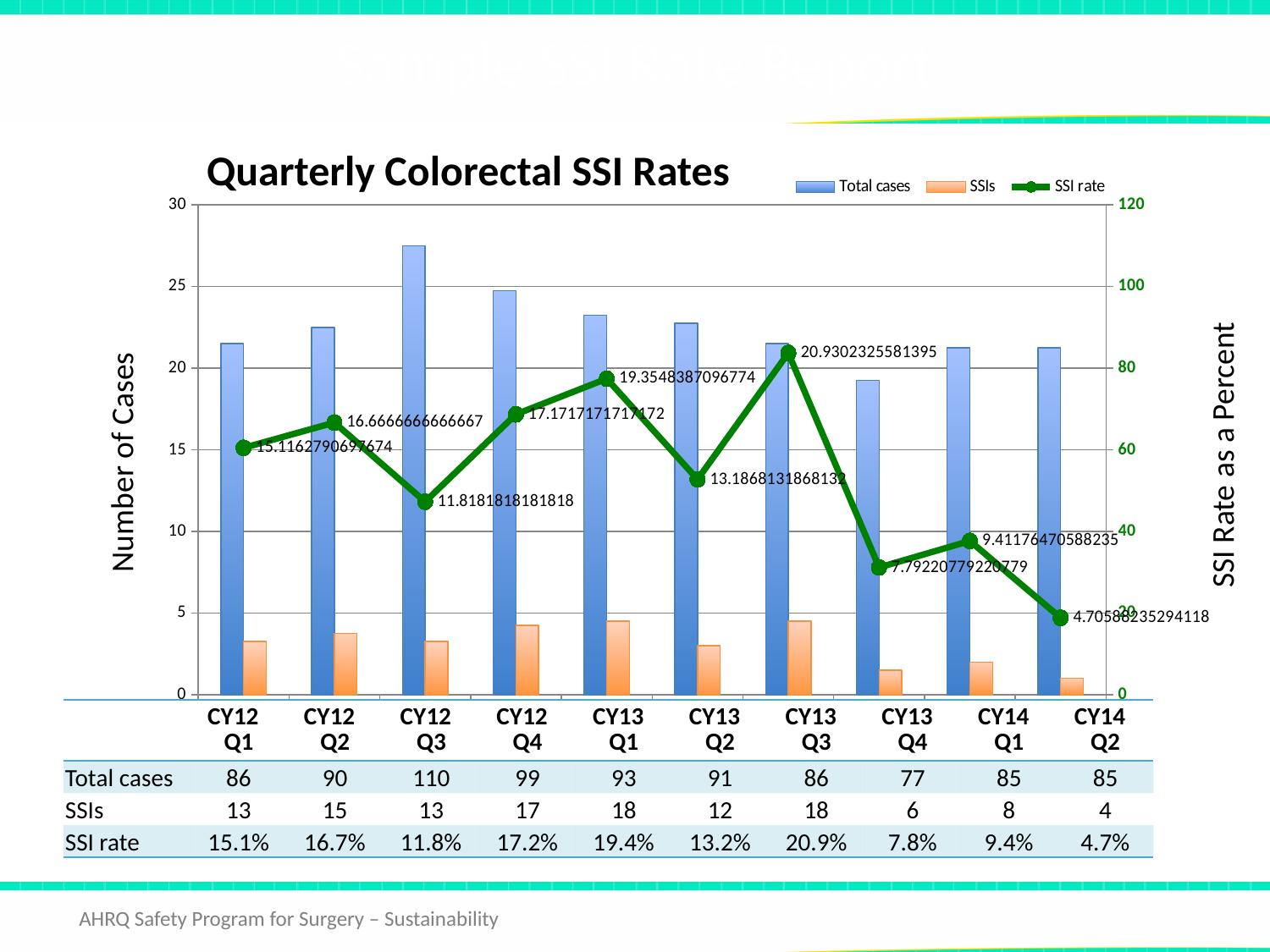
How many SSIs are shown for CY13 Q4? 6 What is the value of Total cases for CY12 Q3? 110 What is the SSI rate for CY13 Q1? 19.4% Does the SSI rate rise or fall from CY13 Q3 to CY14 Q2? Fall Which quarter has the highest SSI rate? CY13 Q3 How many quarters are shown on the x axis? 10 How many series does the legend list? 3 What is the difference in Total cases between CY12 Q3 and CY13 Q4? 33 What kind of chart is this? Combined bar and line chart Which quarter has the highest number of Total cases? CY12 Q3 Which quarter has more SSIs, CY12 Q4 or CY13 Q2? CY12 Q4 Which quarter has the lowest SSI rate? CY14 Q2